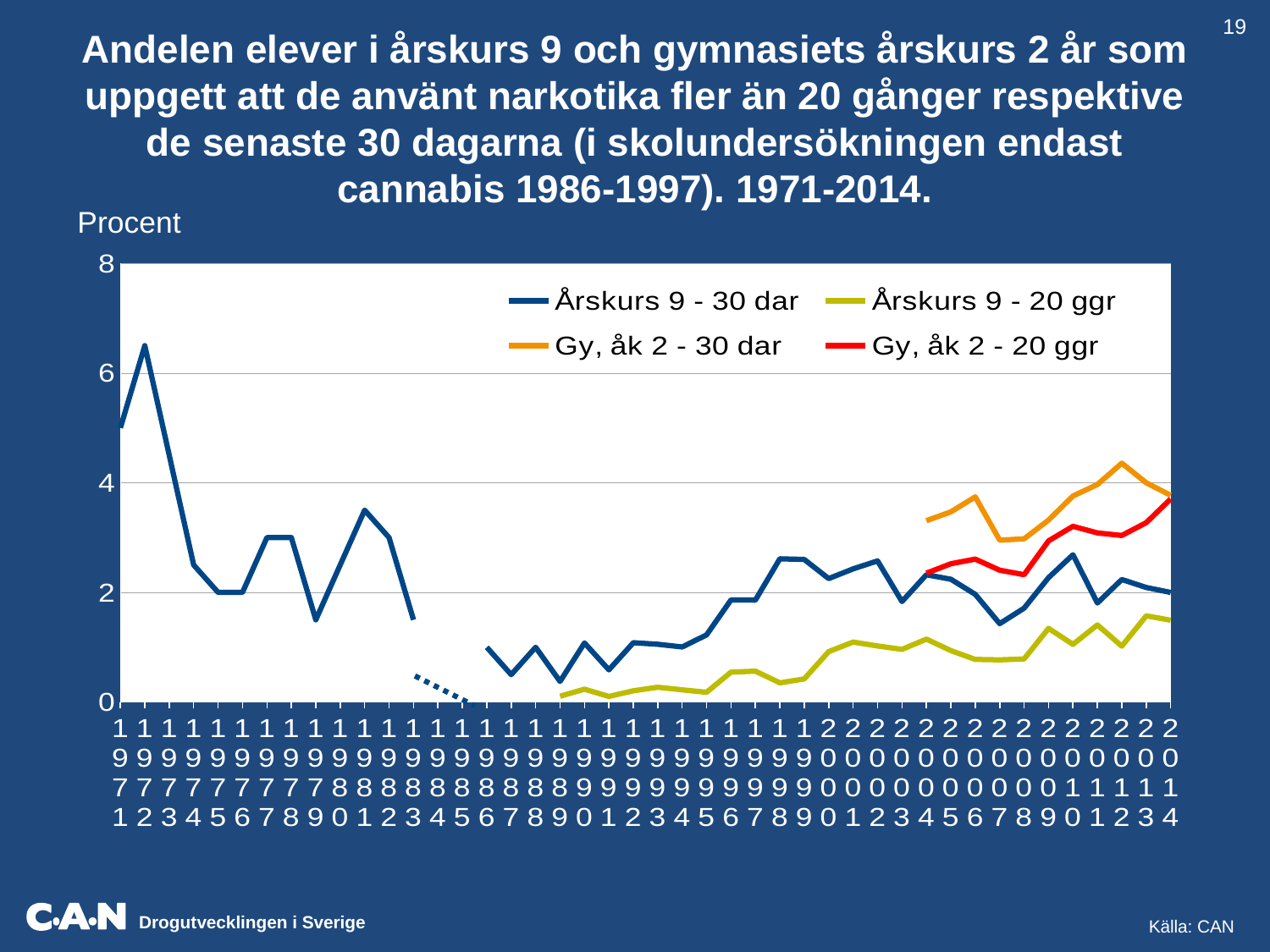
What kind of chart is shown on the slide? Line chart What is the label on the y axis? Procent Is the value for Årskurs 9 - 30 dar in 1972 greater or less than 6? greater What source is cited at the bottom of the slide? Källa: CAN In which year does Årskurs 9 - 30 dar reach its highest value? 1972 How many series does the legend list? 4 How many years are shown along the x axis? 44 Which series has the lowest value in 2014? Årskurs 9 - 20 ggr In 2014, which is higher: Gy, åk 2 - 30 dar or Årskurs 9 - 30 dar? Gy, åk 2 - 30 dar Is the value for Årskurs 9 - 30 dar in 1989 greater or less than 2? less Is the value for Årskurs 9 - 20 ggr in 2014 greater or less than 2? less